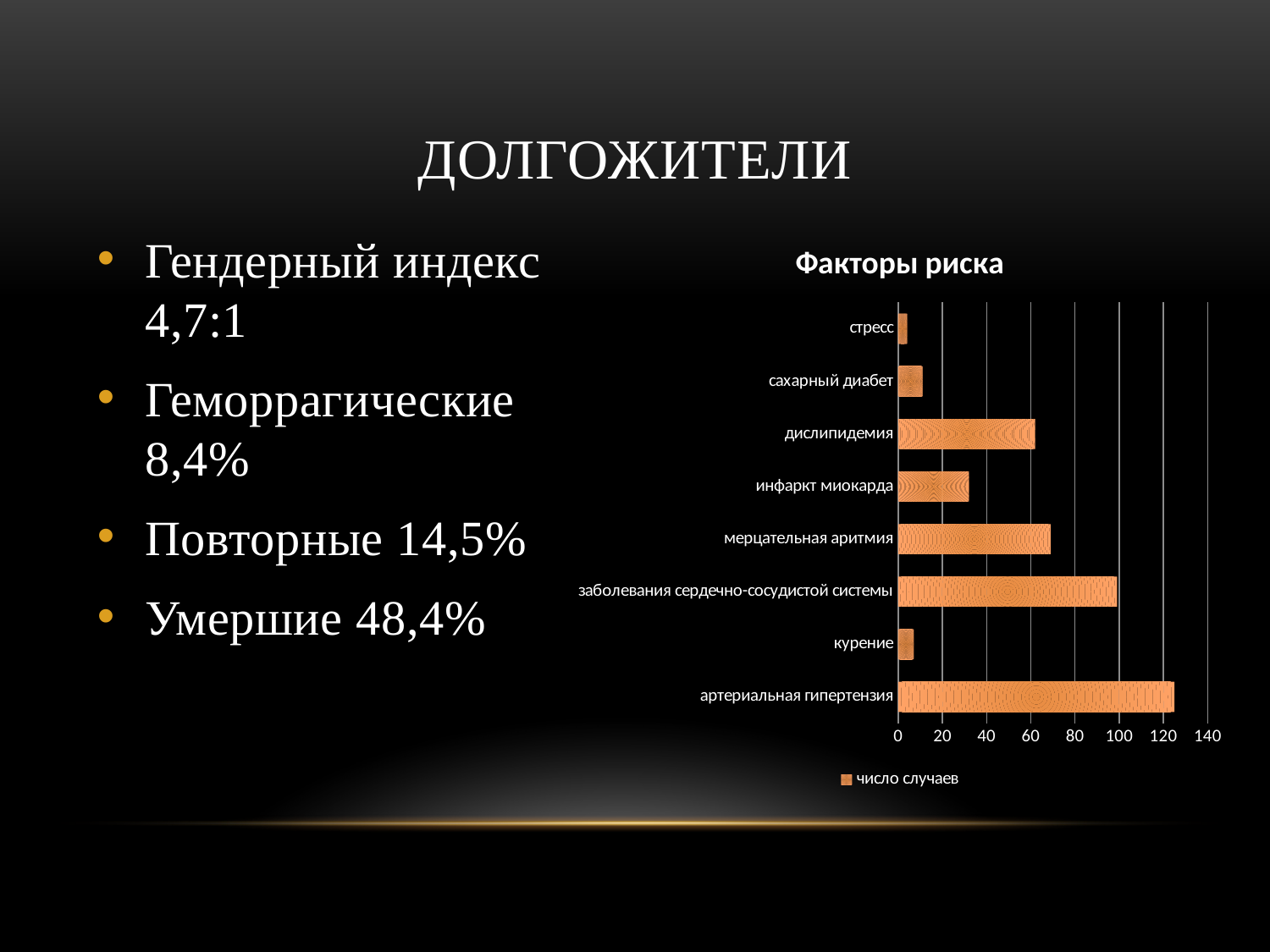
Is the value for сахарный диабет greater or less than 20? less Is the value for инфаркт миокарда greater or less than 40? less Is the value for мерцательная аритмия greater or less than 60? greater Which category has the highest value in the chart? артериальная гипертензия What is the title of the chart? Факторы риска Which has the larger value, дислипидемия or инфаркт миокарда? дислипидемия What series name is shown in the chart legend? число случаев How many series does the chart legend list? 1 How many categories are plotted in the chart? 8 What kind of chart is shown on the slide? bar chart